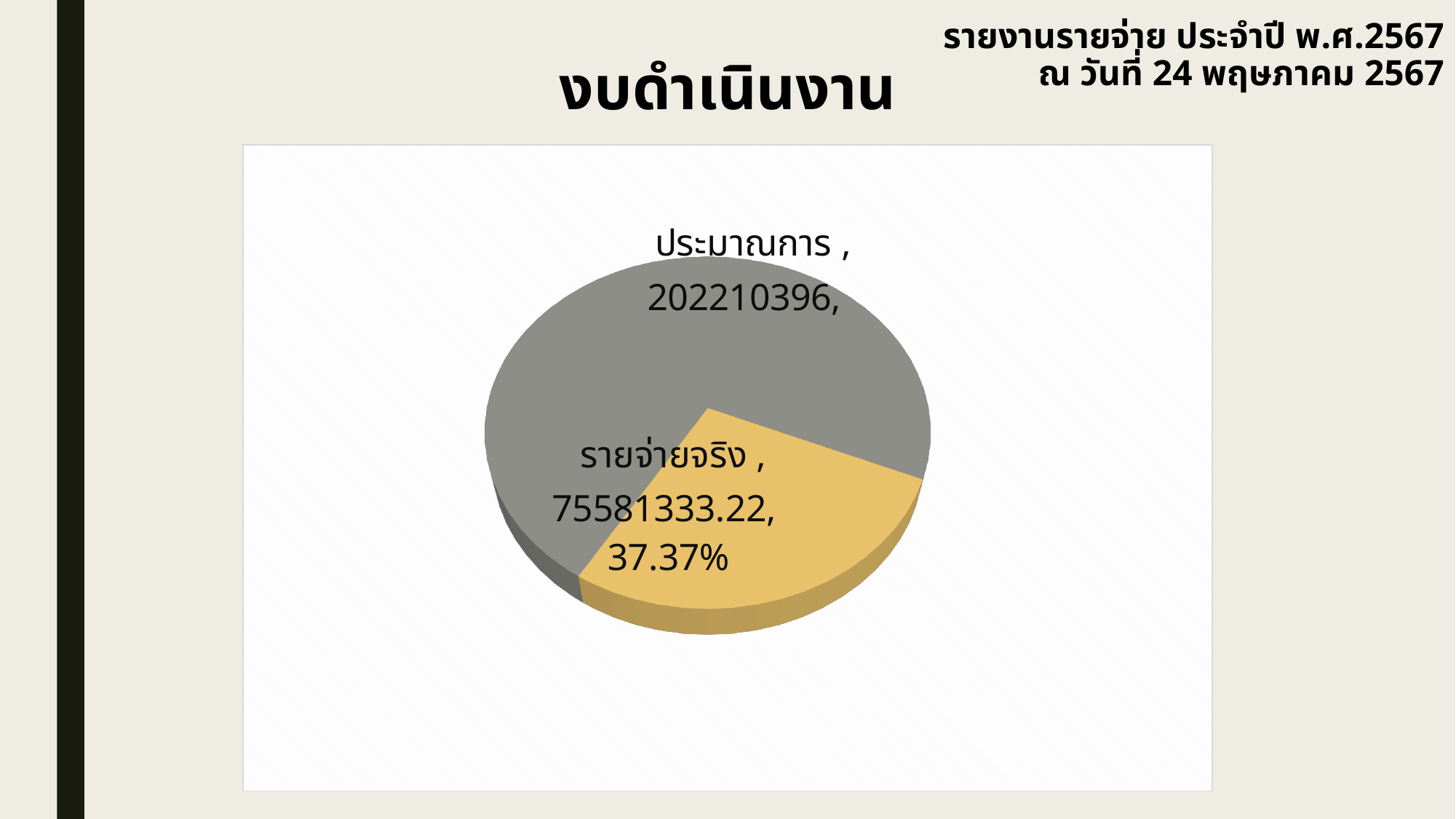
What value is shown for ประมาณการ in the pie chart? 202210396 What is the difference between the value for ประมาณการ and the value for รายจ่ายจริง? 126629062.78 Which is larger, the value for ประมาณการ or the value for รายจ่ายจริง? ประมาณการ What percentage is printed on the รายจ่ายจริง slice? 37.37% Which slice of the pie chart has the largest value? ประมาณการ What is the title shown above the chart? งบดำเนินงาน How many slices does the pie chart have? 2 What value is shown for รายจ่ายจริง in the pie chart? 75581333.22 Which slice of the pie chart has the smallest value? รายจ่ายจริง What colour is the รายจ่ายจริง slice of the pie chart? yellow What kind of chart is shown on the slide? pie chart